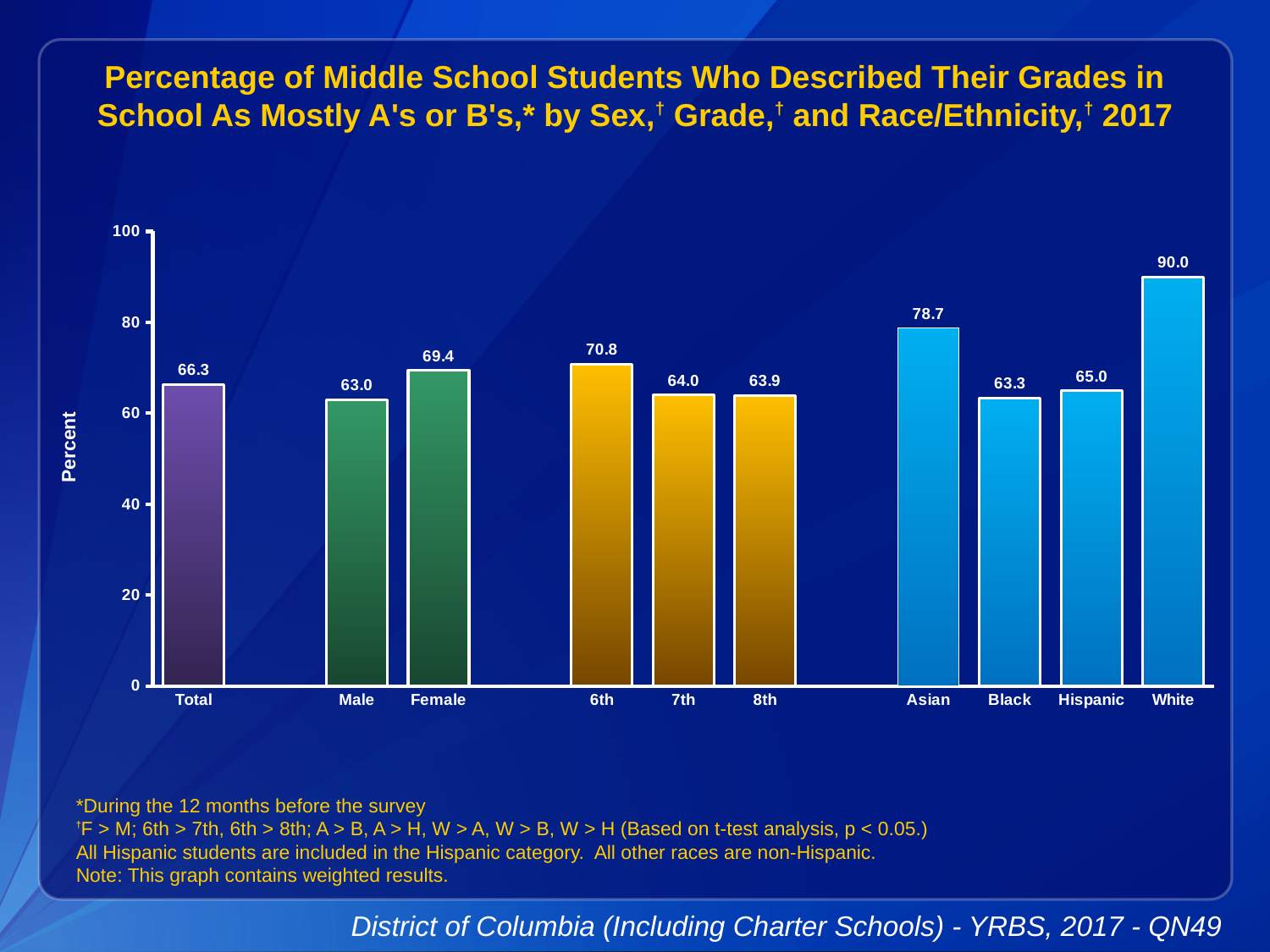
What is the label on the y axis? Percent Which category has the highest value? White How many categories are shown on the x axis? 10 What is the value for Female? 69.4 What kind of chart is this? Bar chart What is the difference between the values for Female and Male? 6.4 What is the value for Asian? 78.7 What is the difference between the values for White and Asian? 11.3 What is the value for Total? 66.3 Which is larger, the value for 6th or the value for 8th? 6th Is the value for Hispanic greater or less than 60? greater Which category has the lowest value? Male